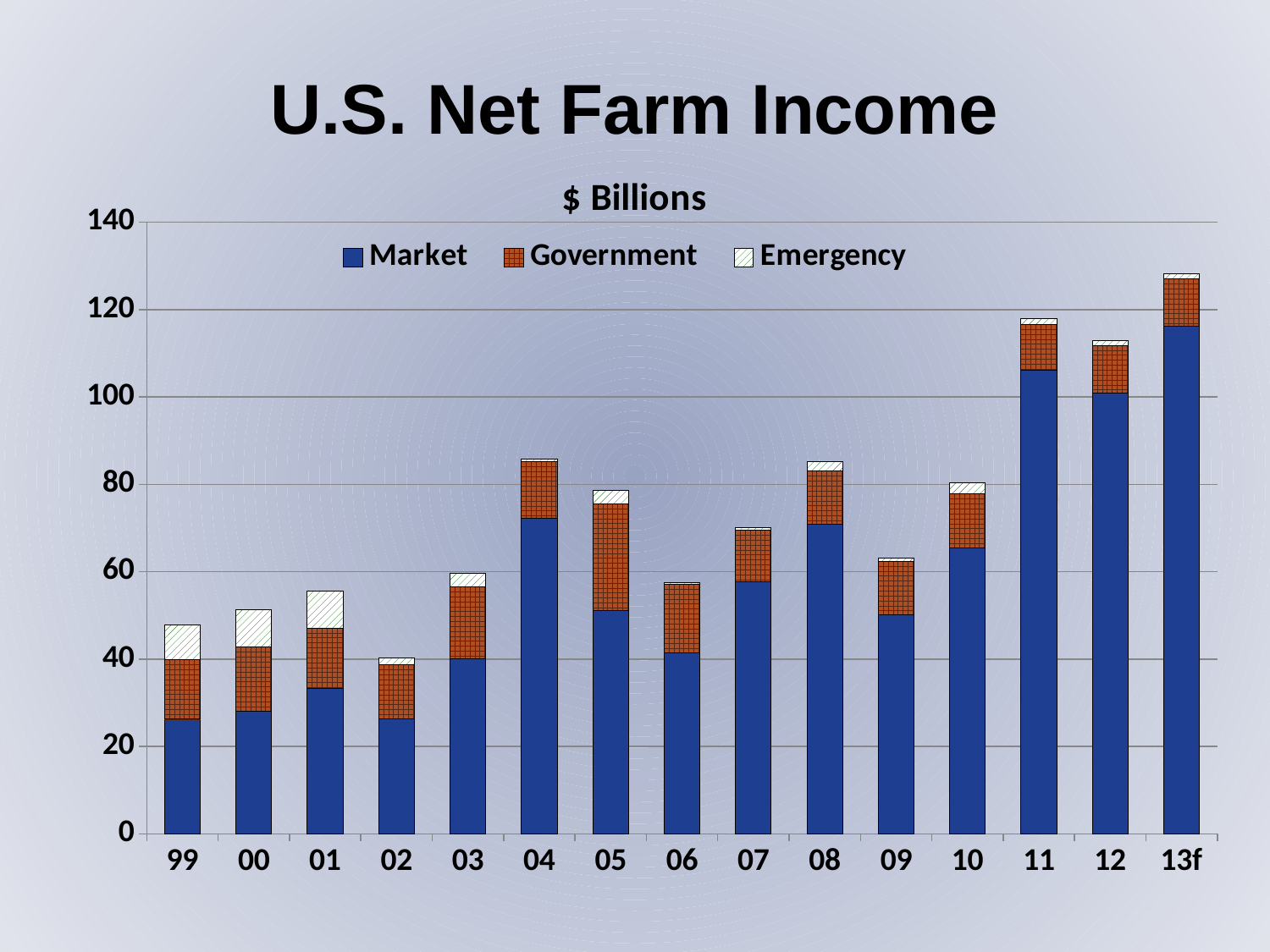
Which year has the larger total, 04 or 05? 04 How many series does the legend list? 3 Is the total for 13f greater or less than 120? greater How many years are shown on the x axis? 15 What unit is stated above the chart? $ Billions Which year has the highest total net farm income? 13f Is the total for 02 greater or less than 60? less What kind of chart is shown on the slide? Stacked bar chart Is the total for 09 greater or less than 80? less Do the totals rise or fall from 99 to 01? rise Which year has the lowest total net farm income? 02